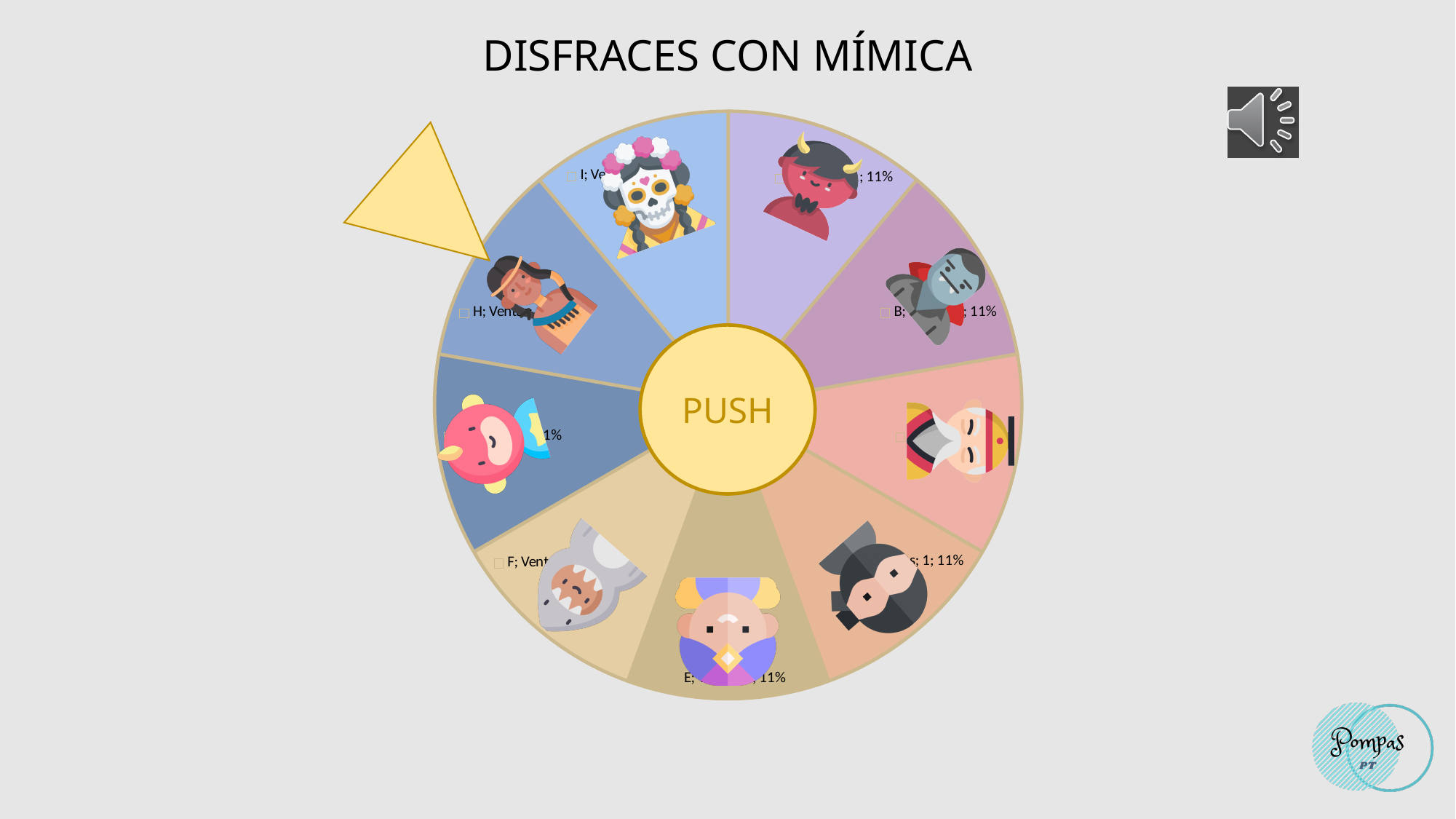
What is the title of the slide containing the pie chart? DISFRACES CON MÍMICA What percentage share is shown for slice E in the pie chart? 11% What percentage share is shown for slice B in the pie chart? 11% What kind of chart is shown on the slide? pie chart What word is written in the circle at the centre of the pie chart? PUSH How many slices does the pie chart have? 9 Are the slices of the pie chart equal in size or different? equal